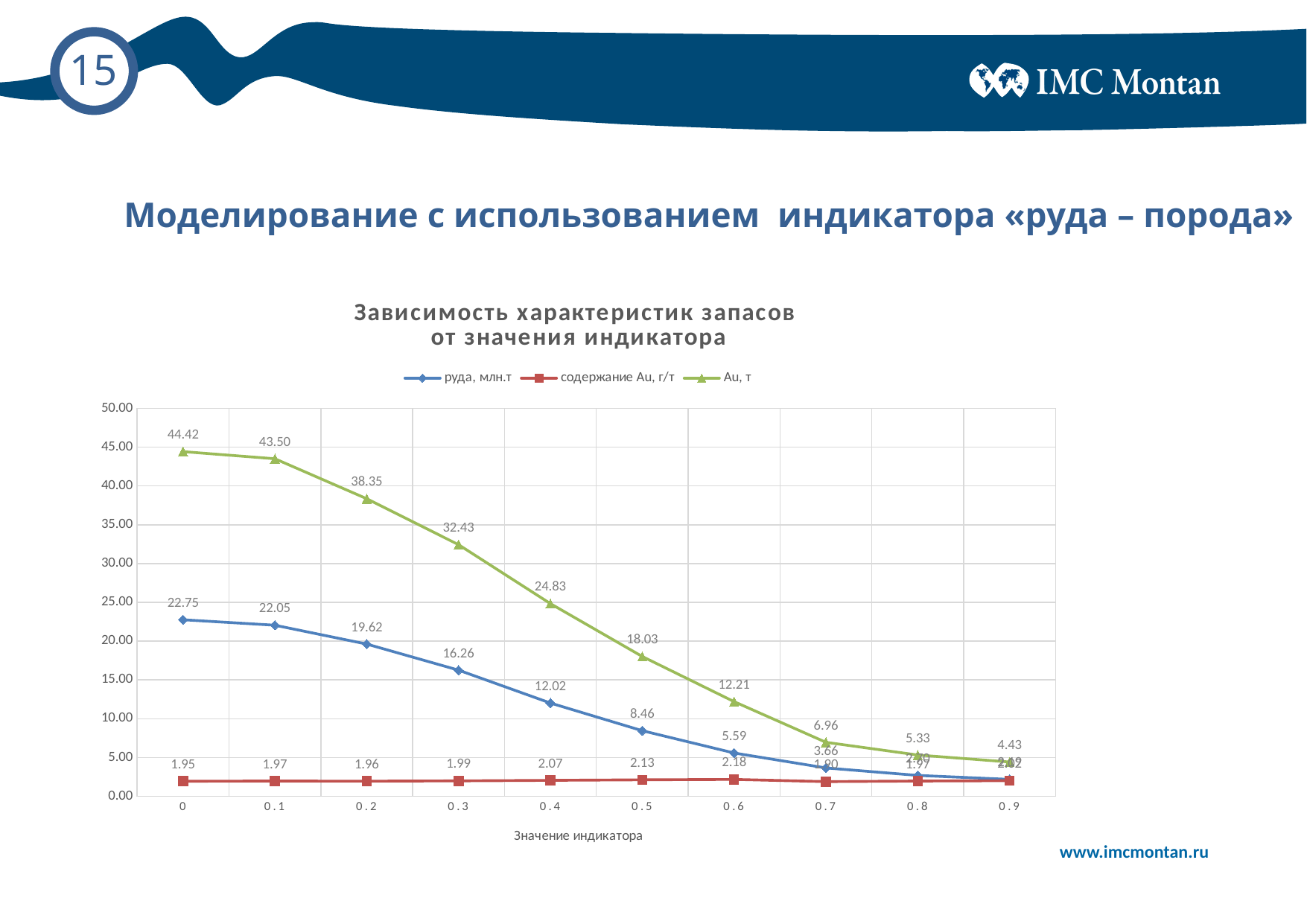
What is the value of the 'руда, млн.т' series at indicator value 0.4? 12.02 What is the value of the 'Au, т' series at indicator value 0.7? 6.96 What is the difference between the 'Au, т' values at indicator 0.2 and 0.3? 5.92 What is the value of the 'содержание Au, г/т' series at indicator value 0.5? 2.13 How many indicator values are plotted along the x axis? 10 What kind of chart is shown on the slide? line chart How many series does the legend list? 3 Which is larger: the 'руда, млн.т' value at 0.5 or the 'Au, т' value at 0.6? Au, т at 0.6 At which indicator value is the 'содержание Au, г/т' series lowest? 0.7 What is the value of the 'Au, т' series at indicator value 0? 44.42 At which indicator value is the 'Au, т' series highest? 0 How does the 'руда, млн.т' series change as the indicator value increases from 0 to 0.9? falls